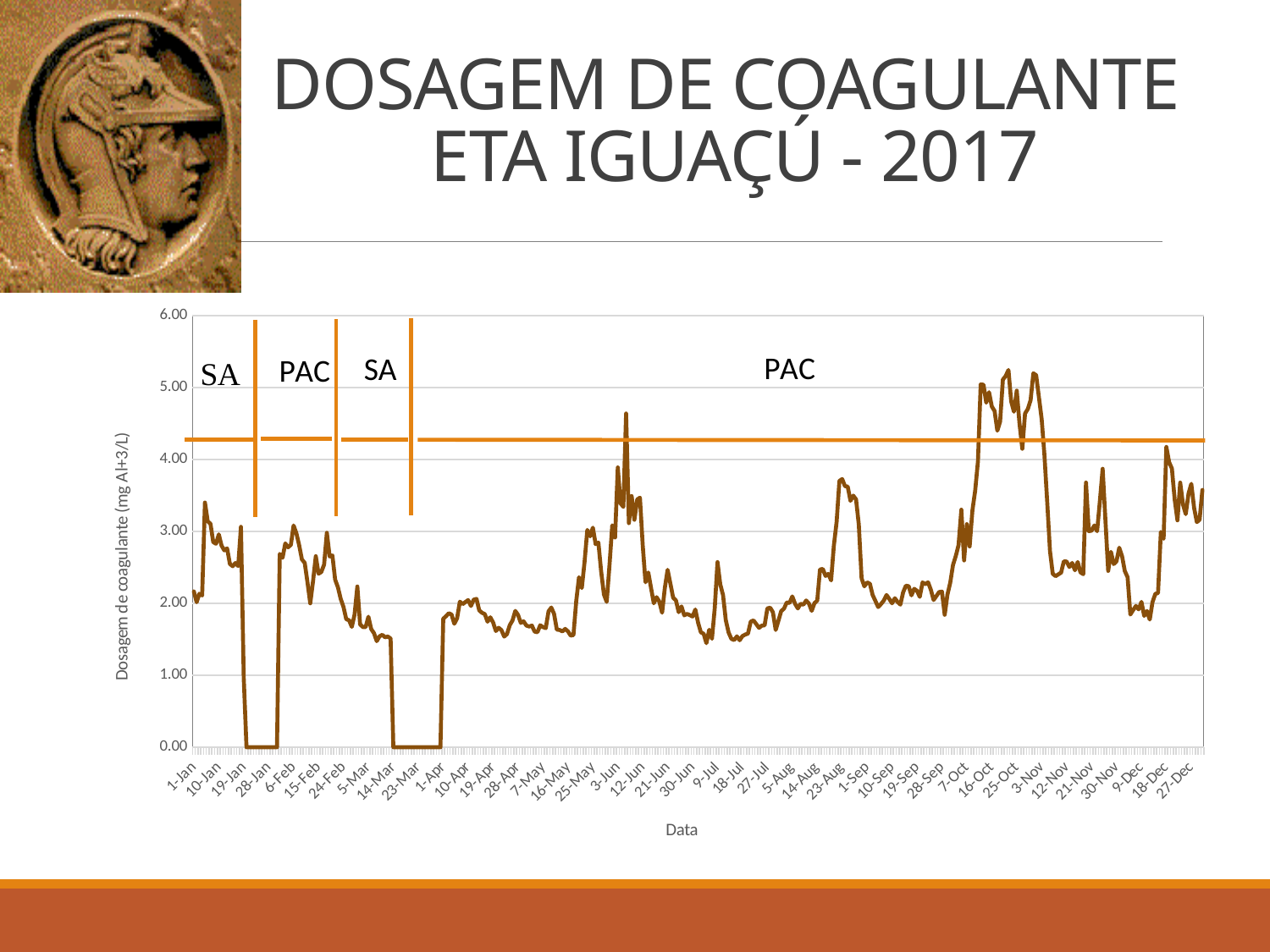
Do the values rise or fall between 7-Oct and 16-Oct? rise Is the value around 16-Oct greater or less than 4.00? greater What is the lowest value the plotted line reaches on the chart? 0.00 Is the value around 23-Aug greater or less than 3.00? greater What kind of chart is shown on the slide? line chart Is the value around 9-Jul greater or less than 2.00? greater What is the title of the y axis of the chart? Dosagem de coagulante (mg Al+3/L) In which month does the plotted line reach its highest values? October Do the values rise or fall between 3-Nov and 12-Nov? fall What is the title of the x axis of the chart? Data